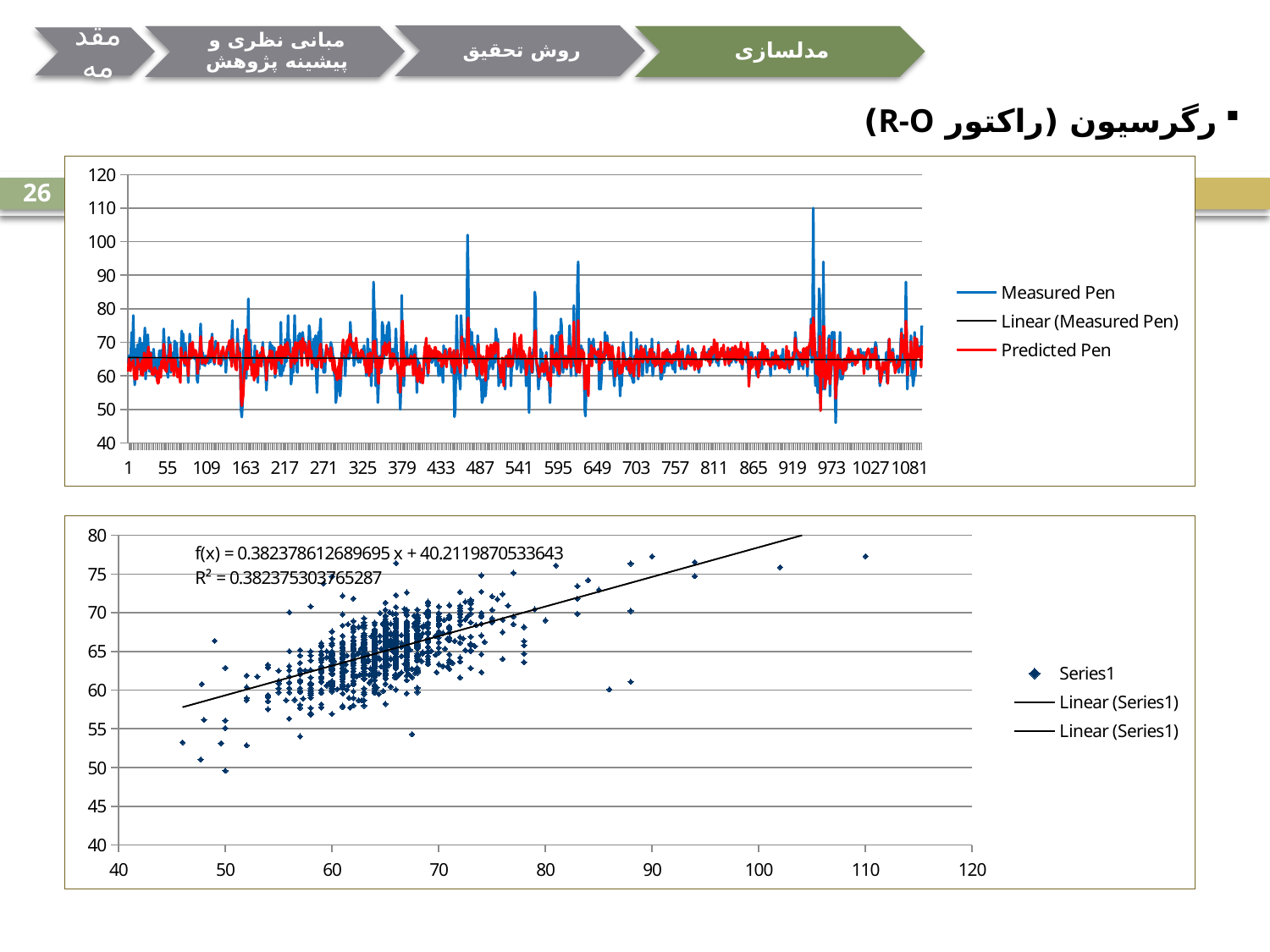
In the top chart, how many tick labels are shown on the x axis? 21 In the bottom chart, what is the equation of the fitted line printed on the chart? f(x) = 0.382378612689695 x + 40.2119870533643 In the bottom chart, how many entries does the legend list? 3 In the top chart, is the lowest value of the Measured Pen series greater or less than 50? less In the bottom chart, what is the R² value printed on the chart? R² = 0.382375303765287 In the bottom chart, does the fitted linear trend line rise or fall as x increases? rises In the top chart, what is the highest value shown on the y axis? 120 In the bottom chart, is the y value of the rightmost point (near x = 110) greater or less than 75? greater What kind of chart is the top chart on the slide? line chart In the top chart, how many entries does the legend list? 3 What kind of chart is the bottom chart on the slide? scatter chart In the top chart, is the highest peak of the Measured Pen series greater or less than 100? greater